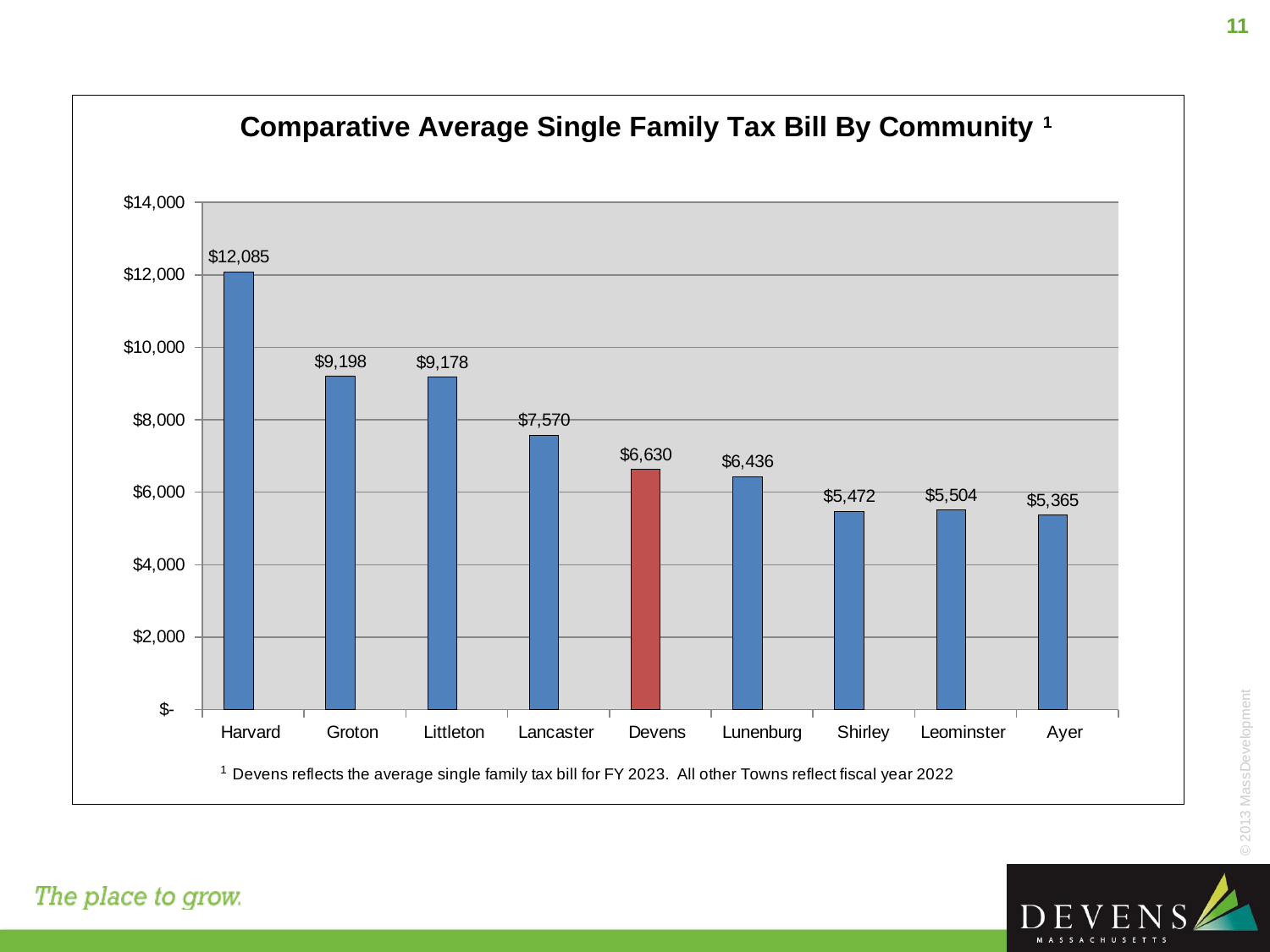
Which community has the highest average single family tax bill? Harvard How many communities are shown in the chart? 9 What is the difference between the tax bills for Harvard and Devens? $5,455 Which has a larger average tax bill, Lunenburg or Shirley? Lunenburg What is the average single family tax bill for Devens? $6,630 What is the average single family tax bill for Leominster? $5,504 What is the difference between the tax bills for Groton and Littleton? $20 Which community has the lowest average single family tax bill? Ayer What is the average single family tax bill for Lancaster? $7,570 Is the value for Lancaster greater or less than $8,000? less What kind of chart is shown on the slide? bar chart Which community's bar is coloured red rather than blue? Devens